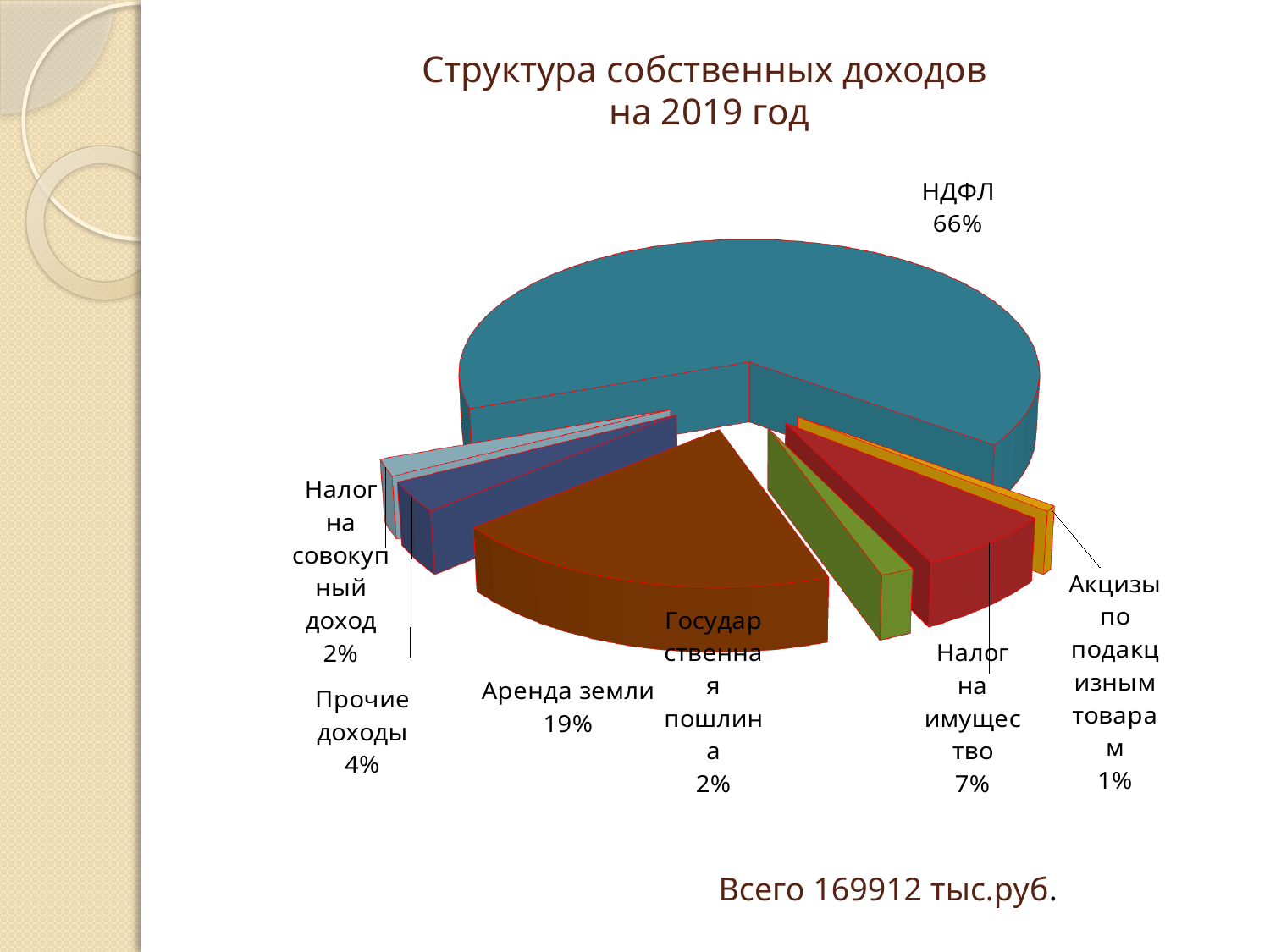
What share of the pie does НДФЛ account for? 66% What percentage is shown for Налог на имущество? 7% What is the difference in percentage points between НДФЛ and Аренда земли? 47 How many slices does the pie chart have? 7 Which category has the largest share of the pie? НДФЛ What is the value shown for Аренда земли? 19% Which is larger, the share for Налог на имущество or the share for Прочие доходы? Налог на имущество What percentage is shown for Прочие доходы? 4% What kind of chart is shown on the slide? Pie chart What percentage is shown for Акцизы по подакцизным товарам? 1% What is the title of the chart? Структура собственных доходов на 2019 год Which category has the smallest share of the pie? Акцизы по подакцизным товарам